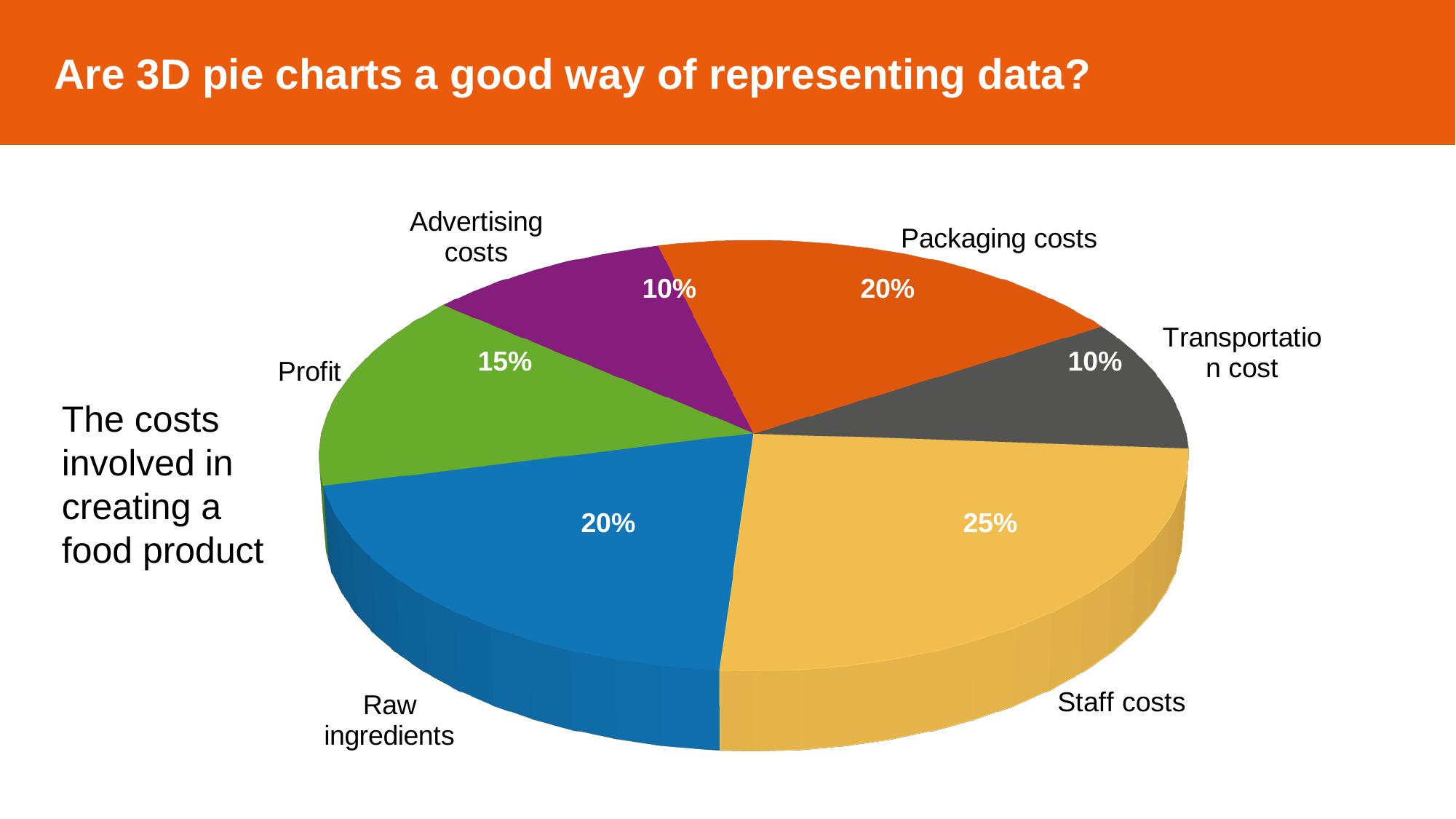
What kind of chart is shown on the slide? Pie chart What percentage of the pie is Raw ingredients? 20% What percentage of the pie is Advertising costs? 10% What is the difference in percentage points between Staff costs and Profit? 10 Which is larger, the share for Profit or the share for Transportation cost? Profit What is the combined share of Packaging costs and Transportation cost? 30% What percentage of the pie is Profit? 15% How many slices does the pie chart have? 6 What percentage of the pie is Packaging costs? 20% What colour is the Staff costs slice? Yellow Which category has the largest share of the pie? Staff costs What percentage of the pie is Staff costs? 25%